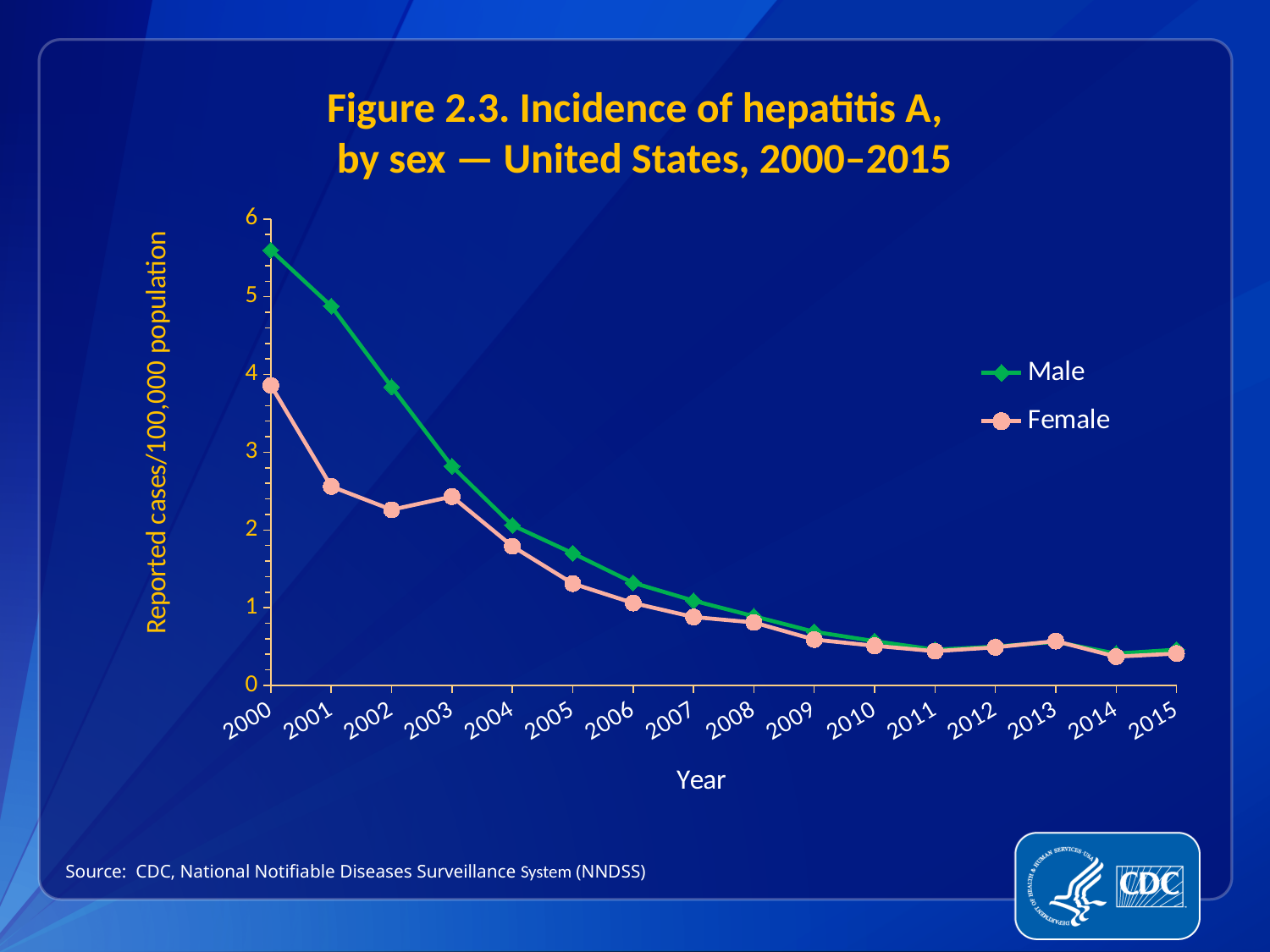
Is the Male value for 2000 greater or less than 5? greater How many years are plotted along the x axis? 16 What kind of chart is shown on the slide? line chart What is the label on the y axis? Reported cases/100,000 population Does the Male incidence rate generally rise or fall from 2000 to 2015? fall Is the Female value for 2009 greater or less than 1? less Is the Male value for 2005 greater or less than 2? less In which year is the Female incidence rate highest? 2000 How many series does the legend list? 2 In 2002, which series has the higher incidence rate, Male or Female? Male In which year is the Male incidence rate highest? 2000